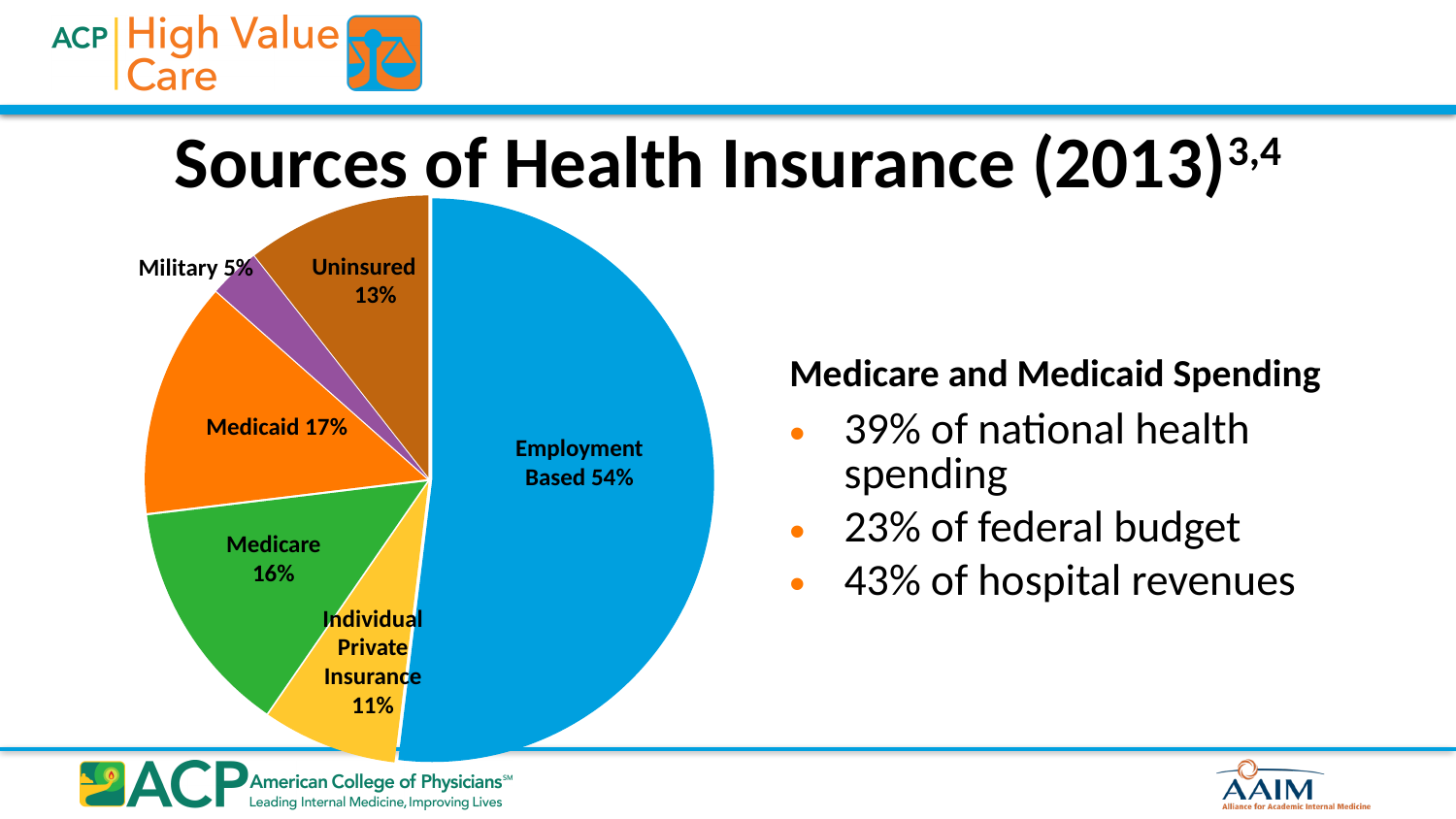
What is the value for Individual Private Insurance? 11% What percentage is shown for Uninsured? 13% What is the difference between the Medicaid and Medicare percentages? 1% Which source of health insurance has the largest slice? Employment Based What is the title of the slide containing the pie chart? Sources of Health Insurance (2013) What kind of chart is shown on the slide? pie chart What share of health insurance sources is Employment Based? 54% How much larger is the Employment Based share than the Uninsured share? 41% How many slices does the pie chart have? 6 Which is larger, the Medicare slice or the Military slice? Medicare What percentage of the pie is Medicaid? 17% Which source of health insurance has the smallest slice? Military